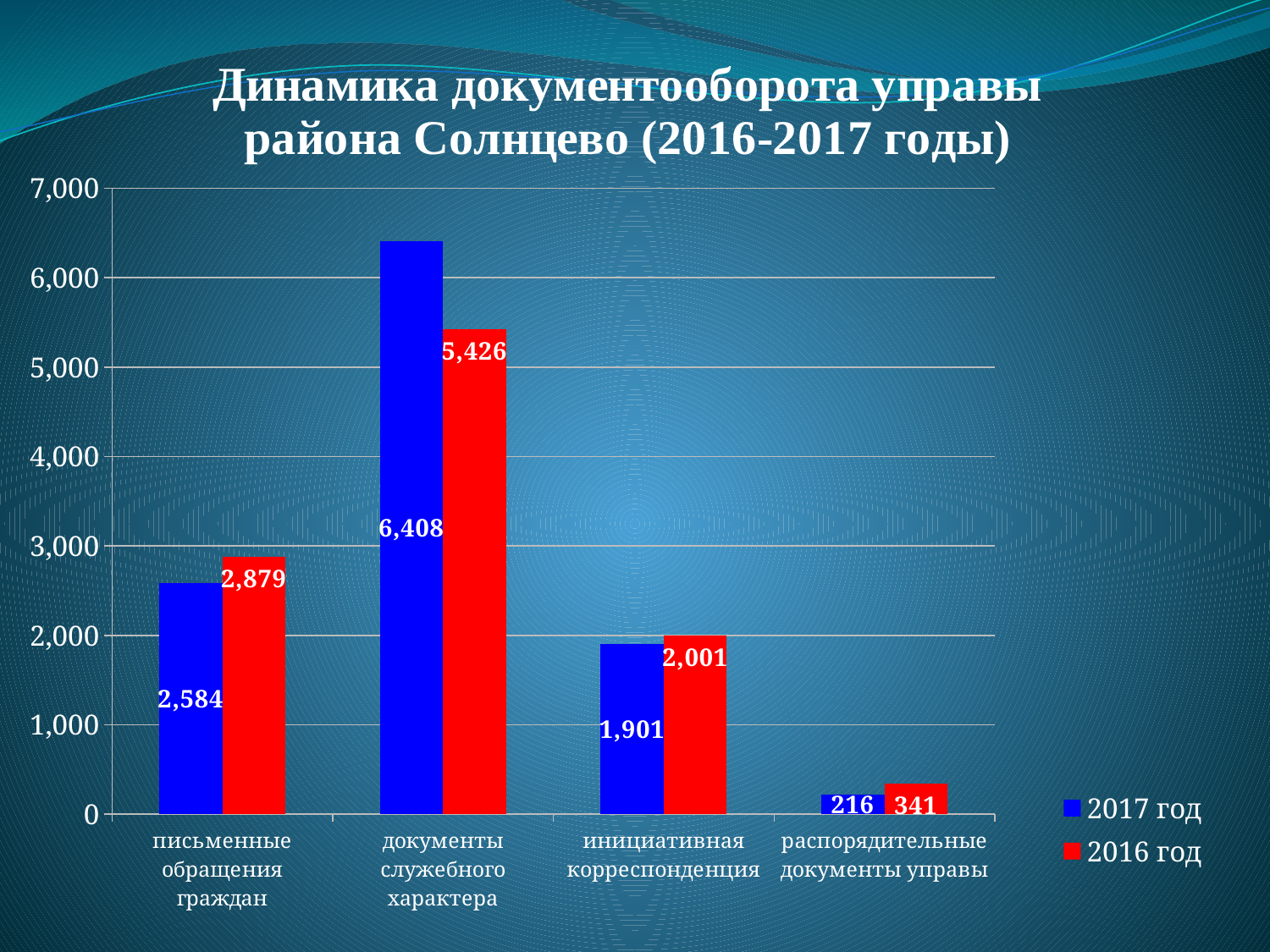
What is the value for 2017 год for распорядительные документы управы? 216 Which is larger for инициативная корреспонденция: the 2017 год value or the 2016 год value? 2016 год How many series does the legend list? 2 Which category has the highest value for 2017 год? документы служебного характера What is the value for 2016 год for инициативная корреспонденция? 2,001 What colour are the bars for 2016 год? red How many categories are shown on the x axis? 4 What is the value for 2016 год for письменные обращения граждан? 2,879 Which category has the lowest value for 2016 год? распорядительные документы управы What is the value for 2017 год for документы служебного характера? 6,408 What is the difference between the 2017 год and 2016 год values for документы служебного характера? 982 What kind of chart is shown on the slide? bar chart